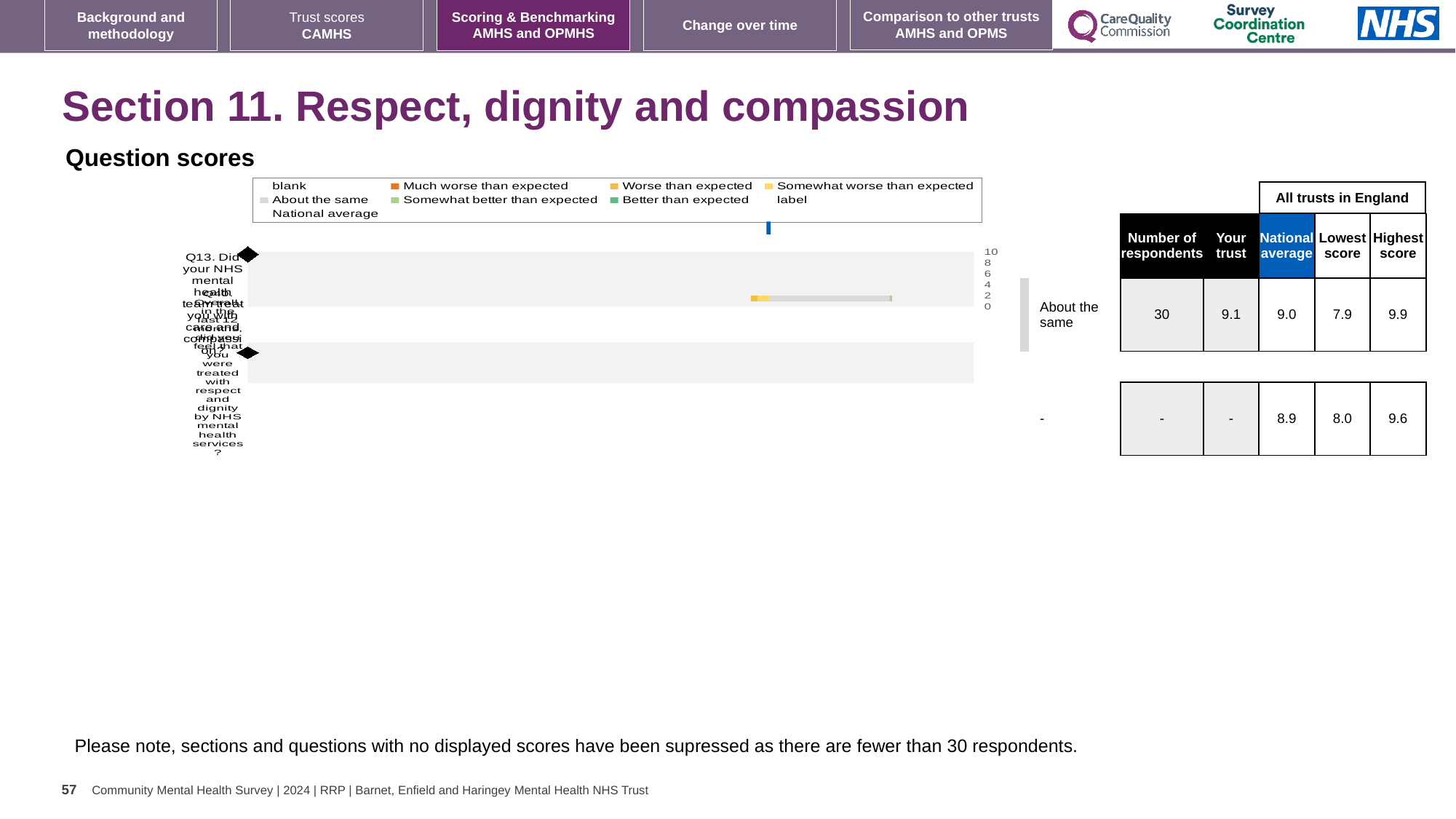
What is the 'Your trust' score for Q13 in the table beside the chart? 9.1 What is the difference between the highest and lowest scores for Q13? 2.0 How many respondents are listed for Q13 in the table beside the chart? 30 What is the lowest score across all trusts in England for Q13? 7.9 What is the national average score for Q13 in the table beside the chart? 9.0 What colour does the legend use for 'About the same' in the 'Question scores' chart? grey For Q13, which is larger: the 'Your trust' score or the national average? Your trust What kind of chart is shown under 'Question scores'? bar chart What is the highest score across all trusts in England for Q13? 9.9 How many entries does the legend of the 'Question scores' chart list? 9 Which benchmark category is shown next to the Q13 bar in the 'Question scores' chart? About the same What is the national average score shown in the second row of the table beside the chart? 8.9